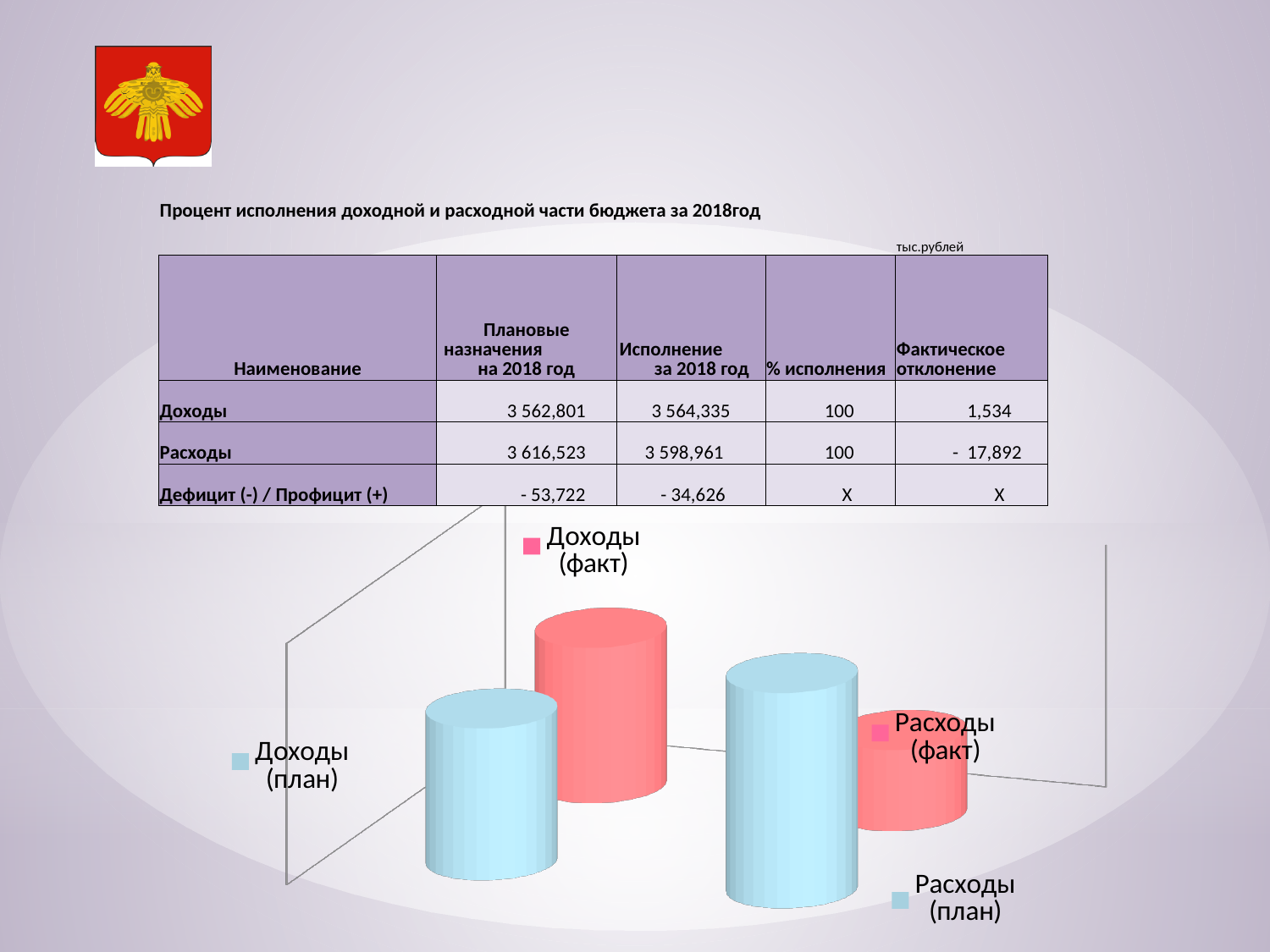
According to the table on the slide, what is the planned value (Плановые назначения на 2018 год) for Расходы? 3 616,523 How many bars (categories) does the chart show? 4 According to the table on the slide, what is the actual value (Исполнение за 2018 год) for Расходы? 3 598,961 According to the table on the slide, what is the actual value (Исполнение за 2018 год) for Доходы? 3 564,335 Which category labels appear on the chart? Доходы (план), Доходы (факт), Расходы (план), Расходы (факт) What colour are the bars for the 'план' categories in the chart? light blue According to the table on the slide, what is the planned value (Плановые назначения на 2018 год) for Доходы? 3 562,801 What kind of chart is shown on the slide? bar chart